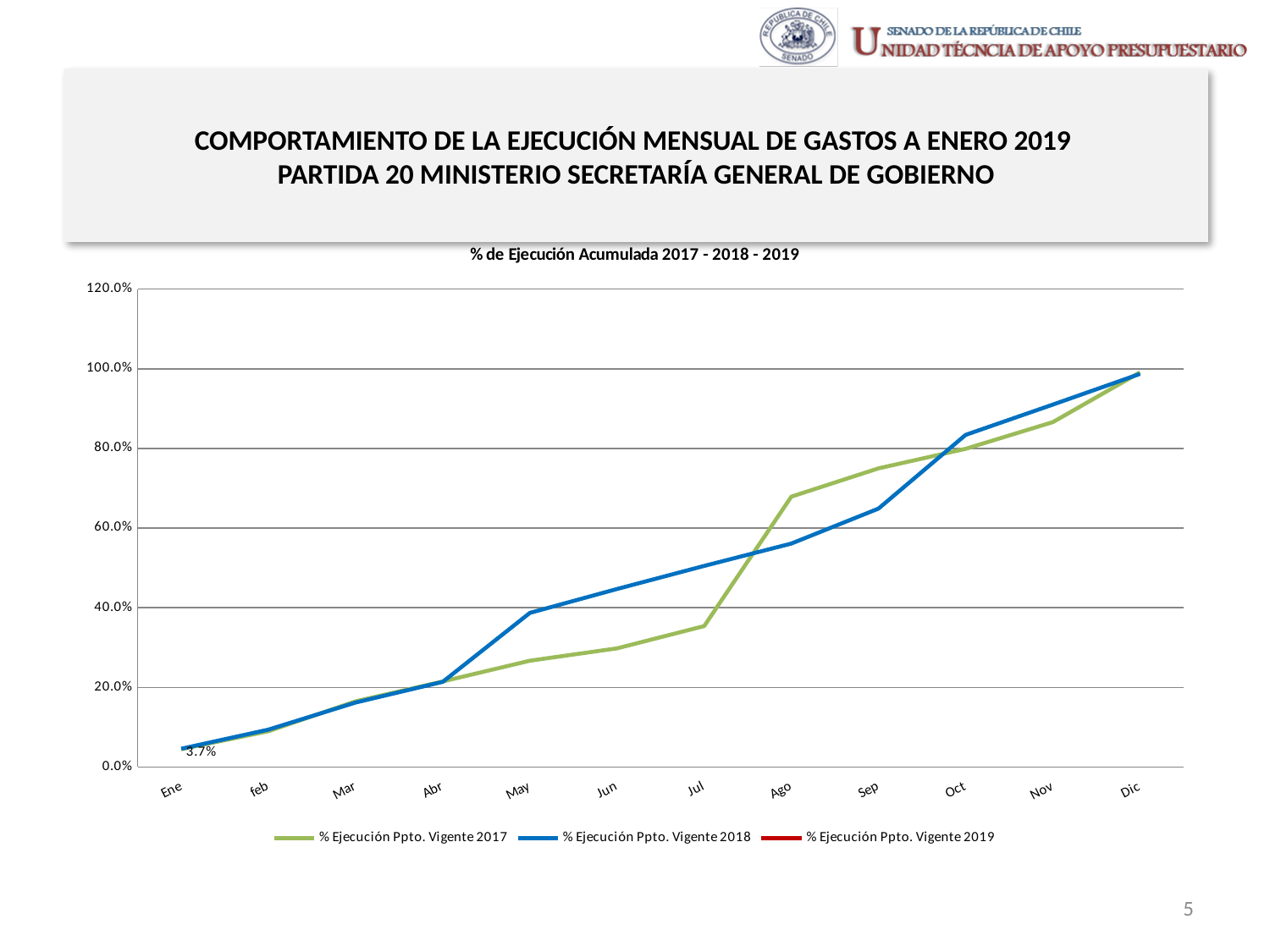
What value is printed as a data label at Ene? 3.7% How many months are shown along the x axis? 12 Is the value for % Ejecución Ppto. Vigente 2017 in Jul greater or less than 40.0%? less What is the title of the chart? % de Ejecución Acumulada 2017 - 2018 - 2019 In May, which series is higher: % Ejecución Ppto. Vigente 2017 or % Ejecución Ppto. Vigente 2018? % Ejecución Ppto. Vigente 2018 In Ago, which series is higher: % Ejecución Ppto. Vigente 2017 or % Ejecución Ppto. Vigente 2018? % Ejecución Ppto. Vigente 2017 How many series does the legend list? 3 Do the values for % Ejecución Ppto. Vigente 2018 rise or fall from Ene to Dic? rise What kind of chart is shown on the slide? line chart Is the value for % Ejecución Ppto. Vigente 2018 in Dic greater or less than 100.0%? less Is the value for % Ejecución Ppto. Vigente 2018 in Ago greater or less than 60.0%? less